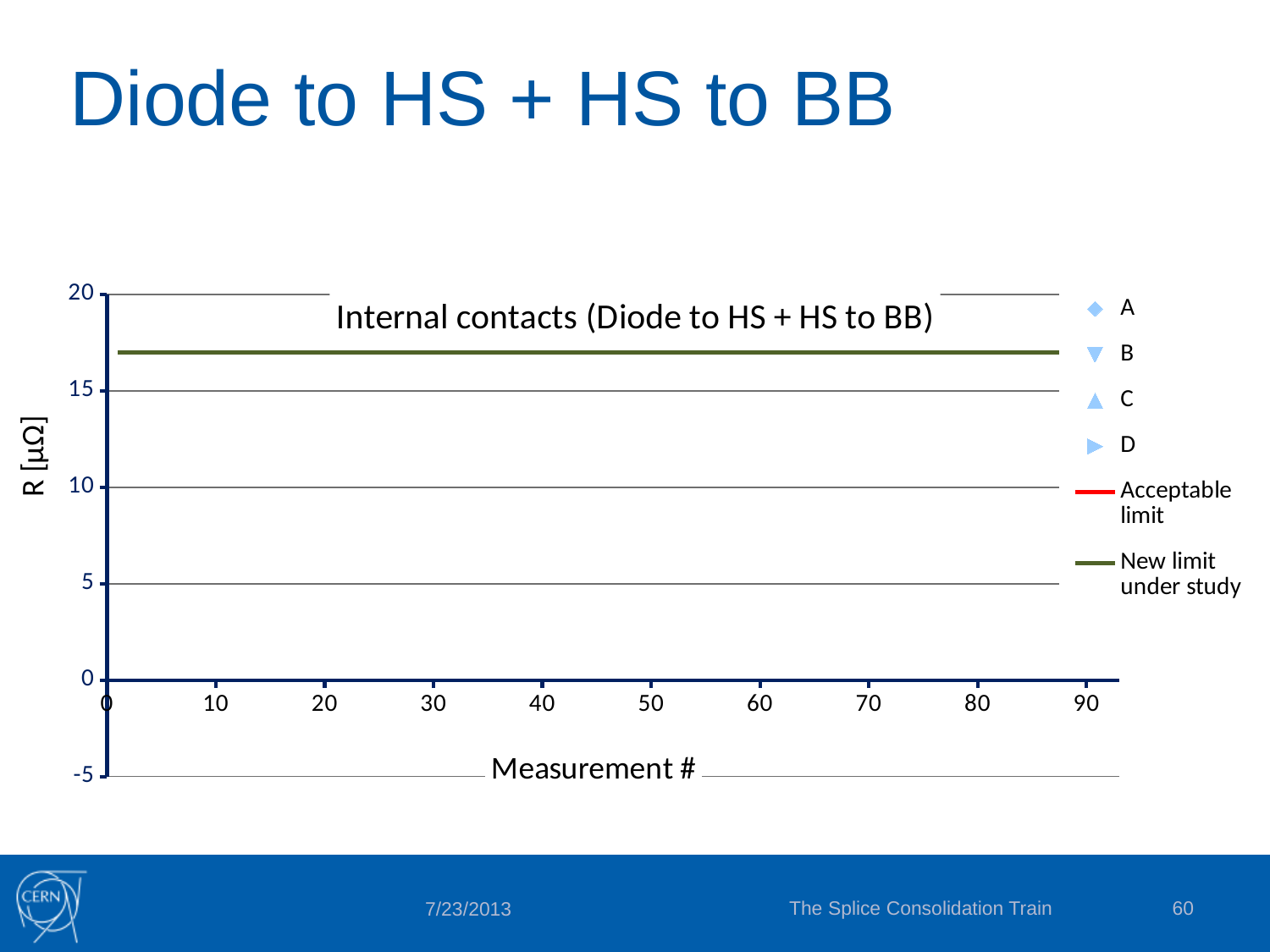
Is the value of the 'New limit under study' line greater or less than 20? less Does the 'New limit under study' line rise, fall, or stay flat along the x axis? stays flat What is the title of the chart? Internal contacts (Diode to HS + HS to BB) Is the 'New limit under study' line greater or less than 10? greater What is the label of the chart's y axis? R [µΩ] Is the value of the 'New limit under study' line greater or less than 15? greater How many series does the chart's legend list? 6